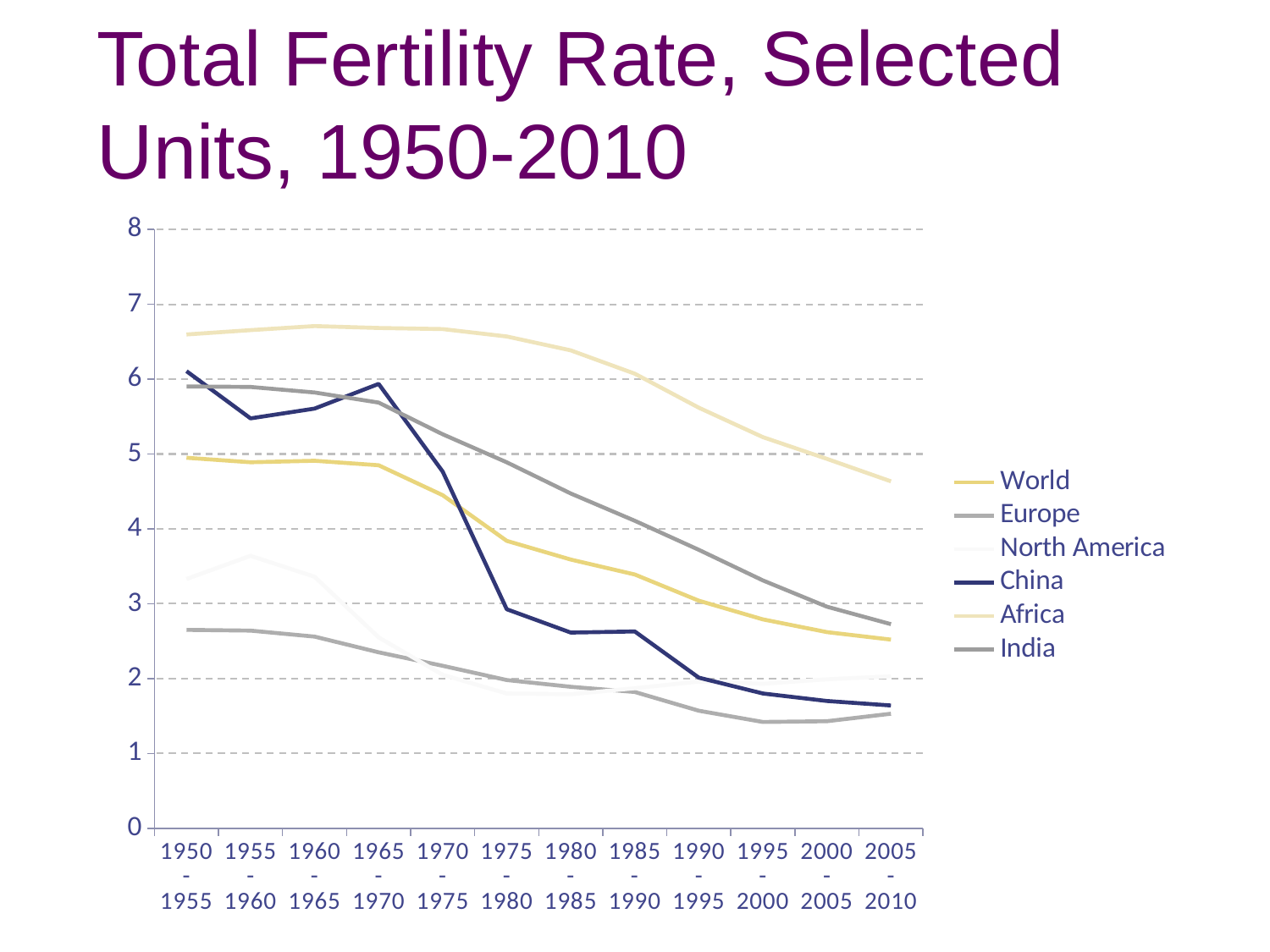
In the 1985-1990 period, which is higher, Africa or World? Africa In the 1970-1975 period, which is higher, India or Europe? India Which series has the highest value in the 2005-2010 period? Africa Does the China line rise or fall overall from 1950-1955 to 2005-2010? Fall Is the value for World in 2005-2010 greater or less than 3? less What colour is the China line in the legend? Dark blue Is the value for China in 1980-1985 greater or less than 3? less What kind of chart is shown on the slide? Line chart How many series does the legend list? 6 Which series has the lowest value in the 1995-2000 period? Europe Is the value for Africa in 1950-1955 greater or less than 6? greater How many time periods are shown along the x axis? 12